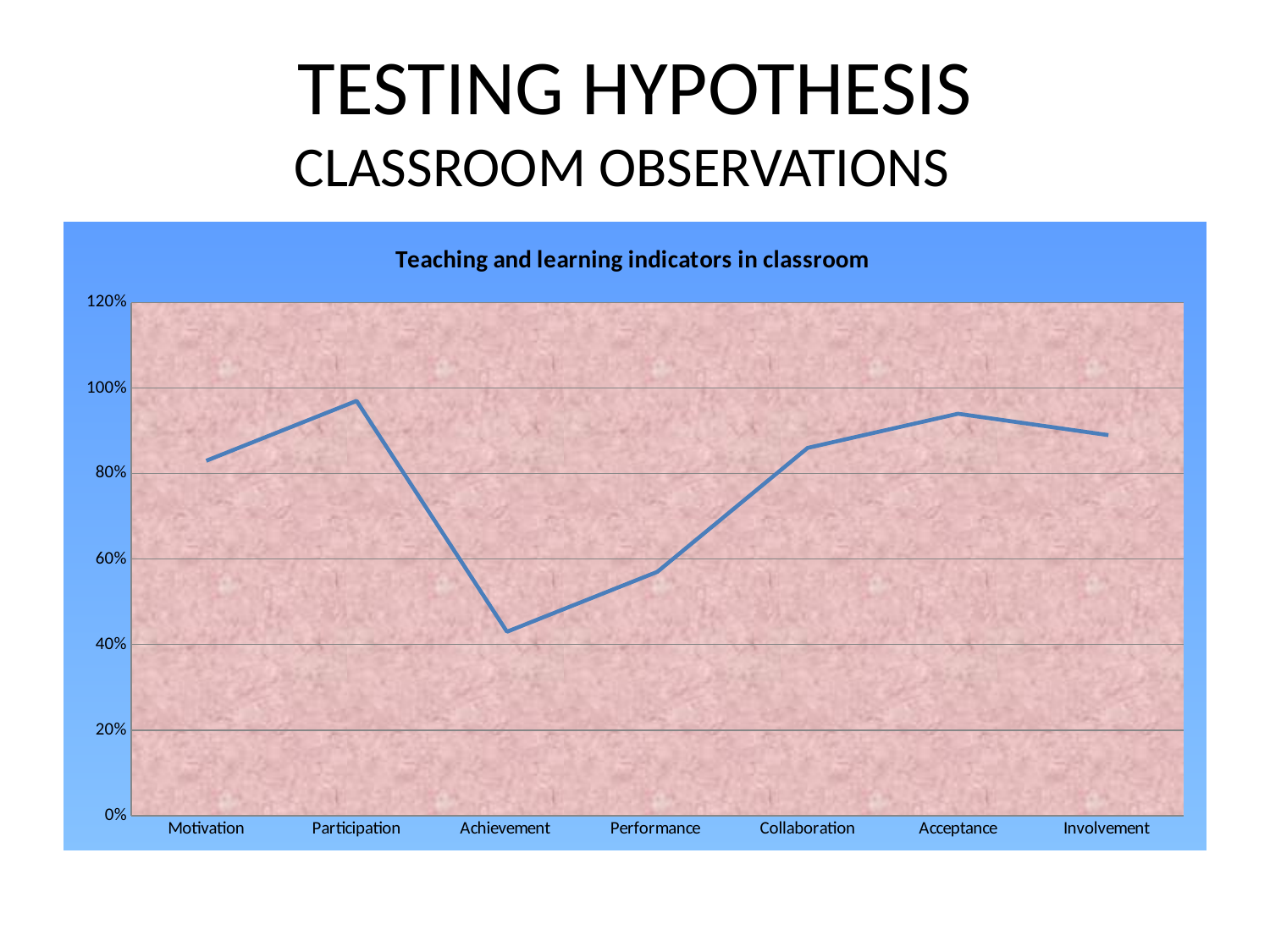
What kind of chart is shown on the slide? line chart Do the values rise or fall from Achievement to Acceptance? rise Which is larger, the value for Performance or the value for Collaboration? Collaboration Is the value for Performance greater or less than 60%? less Is the value for Participation greater or less than 100%? less What is the title of the chart? Teaching and learning indicators in classroom Is the value for Achievement greater or less than 60%? less Which is larger, the value for Participation or the value for Achievement? Participation How many categories are plotted along the x axis? 7 Which category has the lowest value? Achievement